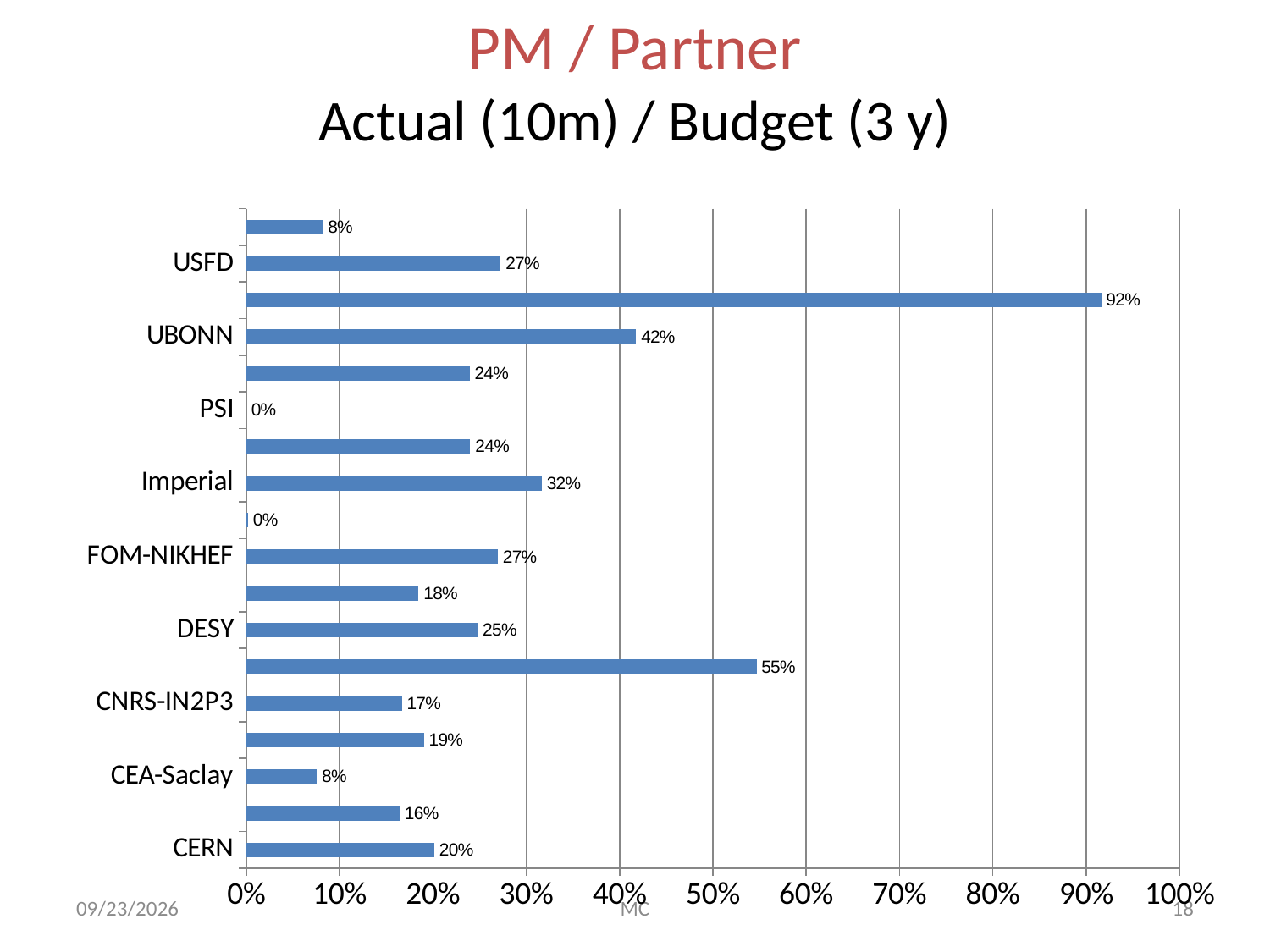
How many bars are plotted on the chart? 18 What is the highest value shown on the chart? 92% Which is larger, the value for Imperial or the value for DESY? Imperial What kind of chart is shown on the slide? Bar chart What is the value for Imperial? 32% What is the value for PSI? 0% What is the value for CERN? 20% What is the difference between the values for UBONN and CNRS-IN2P3? 25% Which of the labelled partners has the highest value: USFD, UBONN or DESY? UBONN What is the value for UBONN? 42% Is the value for FOM-NIKHEF greater or less than 20%? greater What is the value for CEA-Saclay? 8%